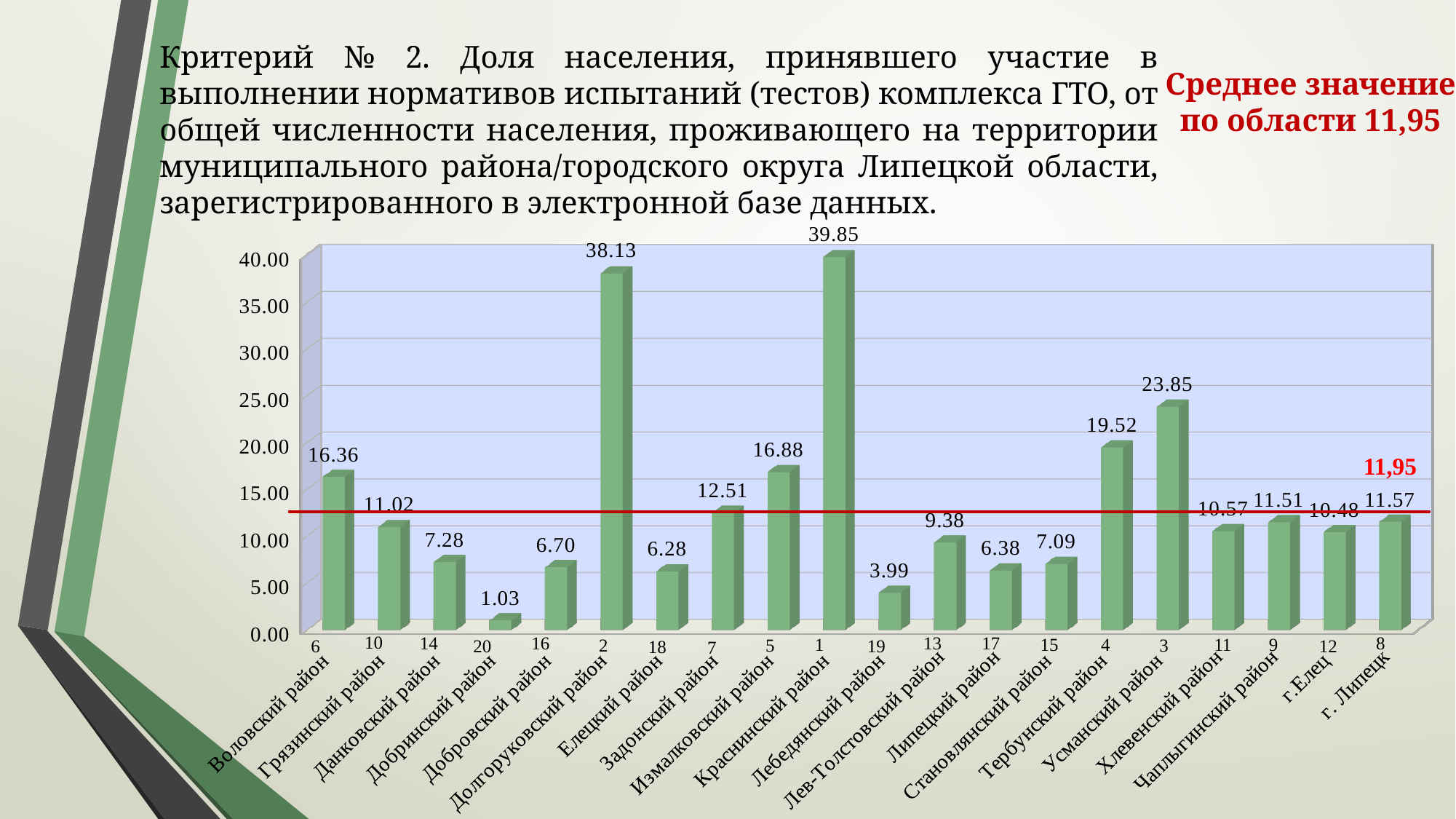
What value is shown for Усманский район? 23.85 What value is shown for г. Липецк? 11.57 Which is larger, the value for Измалковский район or the value for Задонский район? Измалковский район What is the difference between the values for Тербунский район and Воловский район? 3.16 Which district has the lowest value on the chart? Добринский район What is the difference between the values for Краснинский район and Долгоруковский район? 1.72 What value is shown for Долгоруковский район? 38.13 What value does the red horizontal line on the chart mark? 11,95 Is the value for Лебедянский район greater or less than 5.00? less How many districts are shown on the chart? 20 What kind of chart is shown on the slide? bar chart Which district has the highest value on the chart? Краснинский район